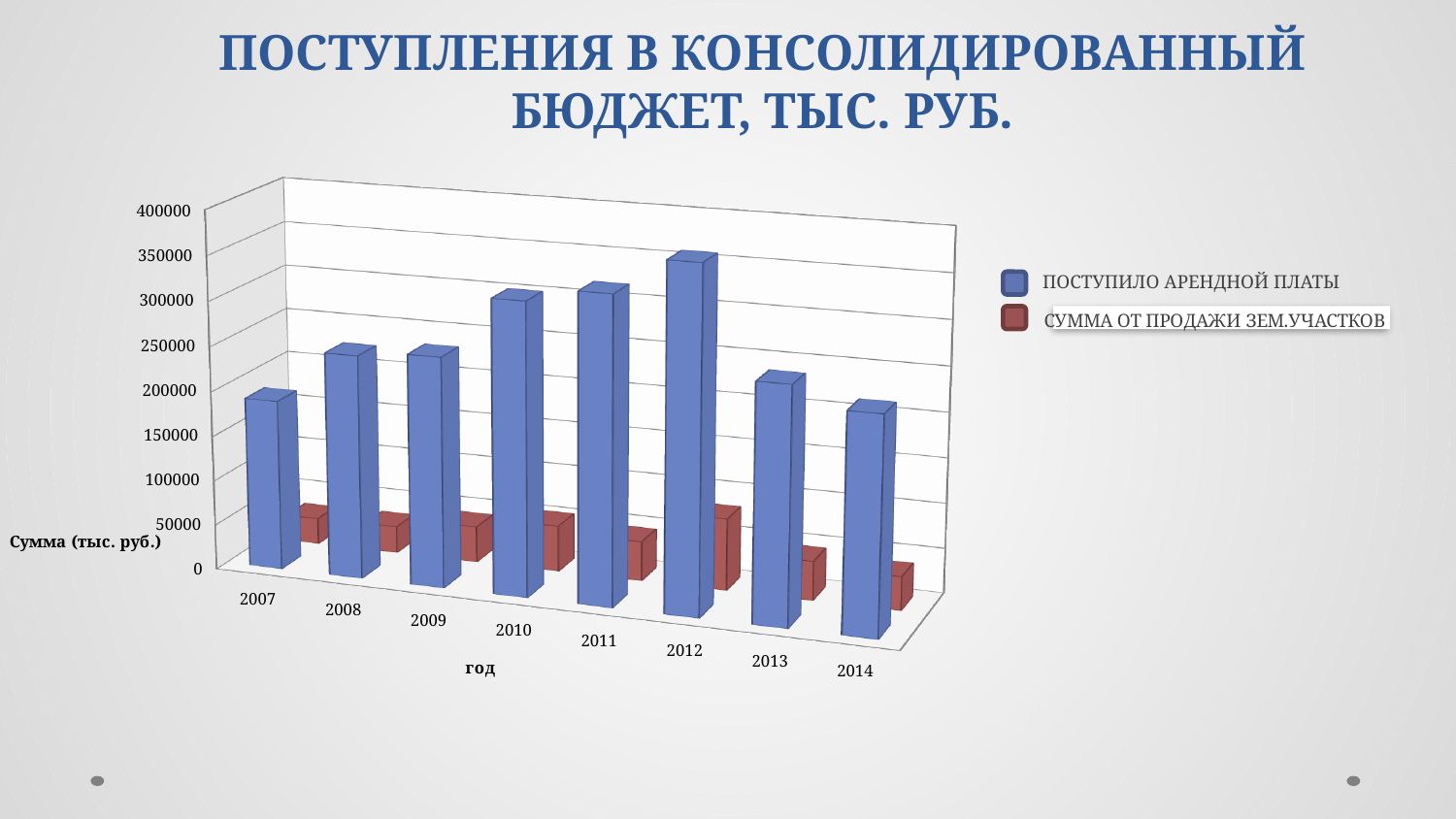
Which year has the highest value for ПОСТУПИЛО АРЕНДНОЙ ПЛАТЫ? 2012 Is the value for ПОСТУПИЛО АРЕНДНОЙ ПЛАТЫ in 2012 greater or less than 300000? greater How many years are shown on the x axis? 8 What kind of chart is shown on the slide? bar chart Is the value for ПОСТУПИЛО АРЕНДНОЙ ПЛАТЫ in 2007 greater or less than 250000? less In 2007, which series has the larger value: ПОСТУПИЛО АРЕНДНОЙ ПЛАТЫ or СУММА ОТ ПРОДАЖИ ЗЕМ.УЧАСТКОВ? ПОСТУПИЛО АРЕНДНОЙ ПЛАТЫ Is the value for СУММА ОТ ПРОДАЖИ ЗЕМ.УЧАСТКОВ in 2007 greater or less than 100000? less How many series does the legend list? 2 Do the values for ПОСТУПИЛО АРЕНДНОЙ ПЛАТЫ rise or fall from 2012 to 2014? fall What is the title of the chart on the slide? ПОСТУПЛЕНИЯ В КОНСОЛИДИРОВАННЫЙ БЮДЖЕТ, ТЫС. РУБ. Which is larger for ПОСТУПИЛО АРЕНДНОЙ ПЛАТЫ: the value in 2010 or the value in 2008? 2010 What colour are the bars for СУММА ОТ ПРОДАЖИ ЗЕМ.УЧАСТКОВ? red